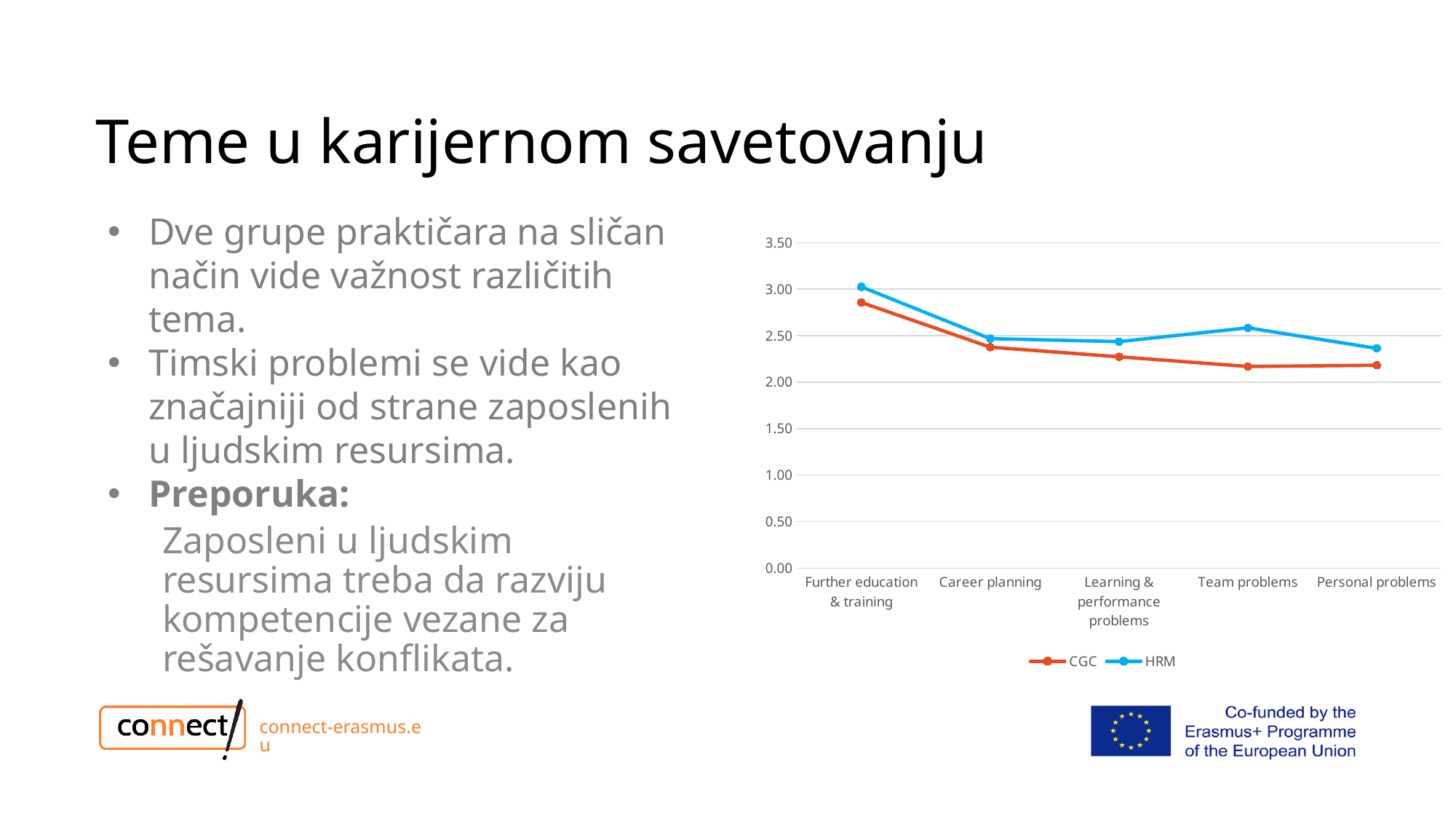
Does the CGC line generally rise or fall from Further education & training to Personal problems? Fall Is the CGC value for Further education & training greater or less than 2.50? greater For which category is the CGC value highest? Further education & training Is the CGC value for Team problems greater or less than 2.50? less Which colour is used for the HRM series in the chart? Blue How many categories are shown on the x axis of the chart? 5 For which category is the HRM value highest? Further education & training For Team problems, which series has the larger value, CGC or HRM? HRM What kind of chart is shown on the slide? Line chart How many series does the chart's legend list? 2 Is the HRM value for Personal problems greater or less than 2.00? greater For Further education & training, which series has the larger value, CGC or HRM? HRM